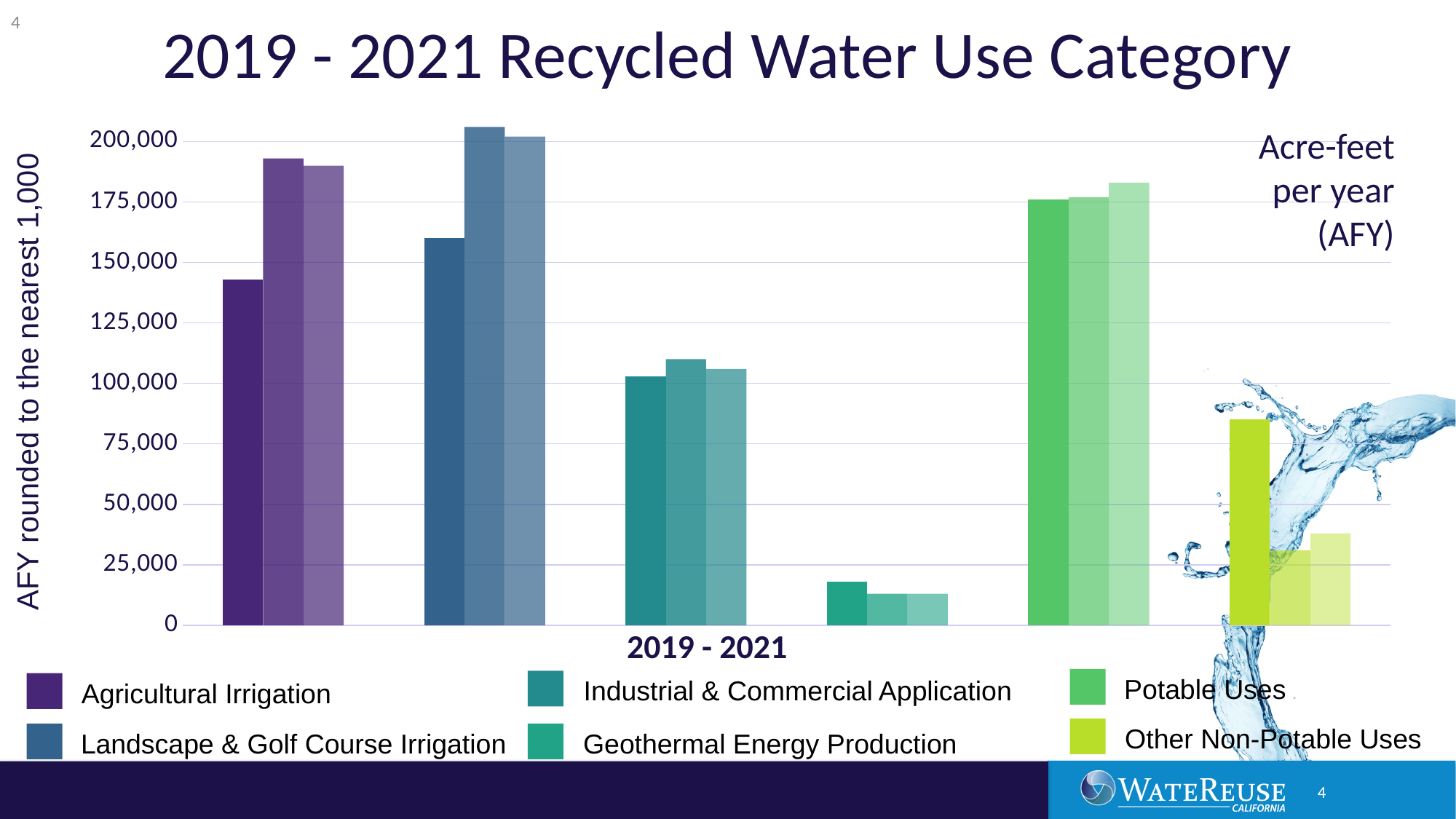
Is the tallest bar for Landscape & Golf Course Irrigation greater or less than 200,000? greater Are the bars for Geothermal Energy Production greater or less than 25,000? less What is the label on the vertical axis of the chart? AFY rounded to the nearest 1,000 Which use category has the lowest bars on the chart? Geothermal Energy Production How many use categories does the legend list? 6 Do the three bars for Potable Uses rise or fall from left to right? rise How many bars are plotted for each use category? 3 Is the leftmost bar for Agricultural Irrigation greater or less than 125,000? greater What kind of chart is shown on the slide? bar chart Which use category has the tallest bar on the chart? Landscape & Golf Course Irrigation Which is larger, the leftmost bar for Agricultural Irrigation or the leftmost bar for Industrial & Commercial Application? Agricultural Irrigation